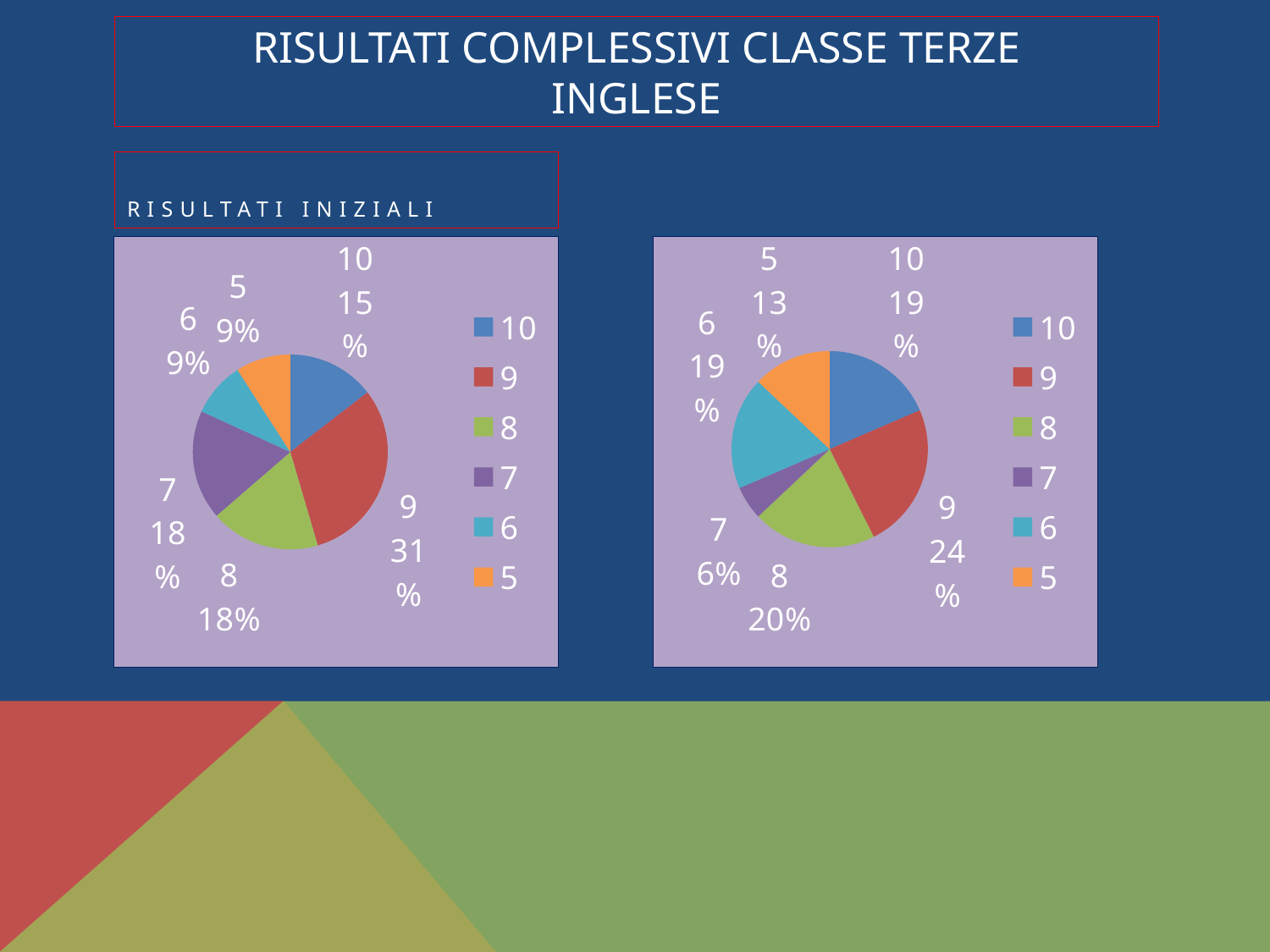
In the pie chart on the right, which grade has the largest slice? 9 In the pie chart on the right, what share does grade 9 have? 24% In the pie chart on the right, which grade has the smallest slice? 7 In the left pie chart (Risultati iniziali), what share does grade 9 have? 31% In the left pie chart (Risultati iniziali), which grade has the largest slice? 9 How many slices does the left pie chart (Risultati iniziali) have? 6 In the left pie chart (Risultati iniziali), what is the difference in percentage points between the shares of grade 9 and grade 8? 13 In the left pie chart (Risultati iniziali), what share does grade 10 have? 15% In the pie chart on the right, which has a larger share, grade 8 or grade 5? 8 How many entries does the legend of the pie chart on the right list? 6 What type of chart is the chart on the left (Risultati iniziali)? Pie chart